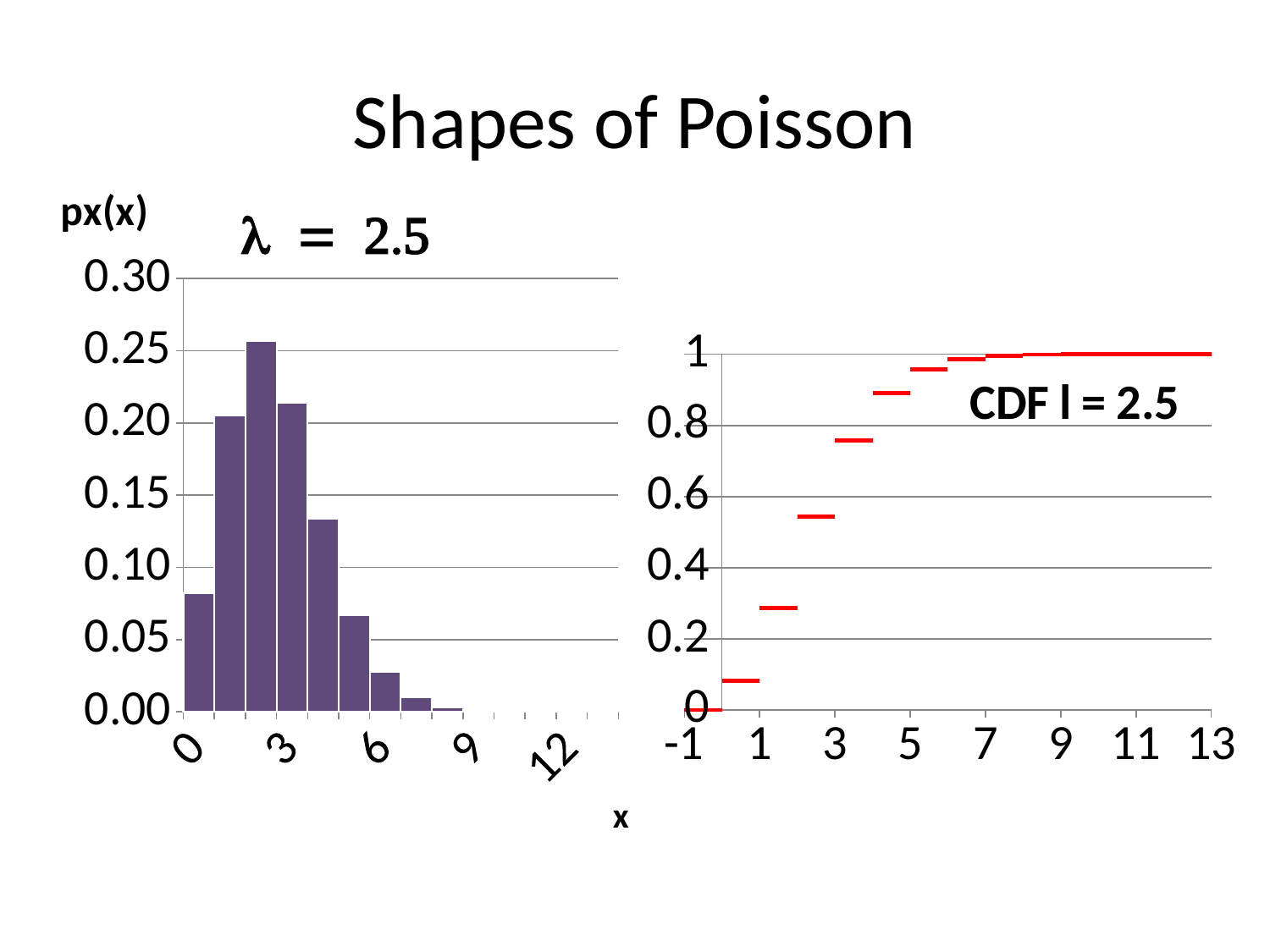
In the left chart (λ = 2.5), is the bar for x = 0 greater or less than 0.10? less In the right chart (CDF l = 2.5), is the value at x = 1 greater or less than 0.4? less In the right chart (CDF l = 2.5), is the value at x = 2 greater or less than 0.4? greater What is the y-axis label of the left chart? px(x) What is the title of the slide? Shapes of Poisson In the left chart (λ = 2.5), which value of x has the tallest bar? 2 What kind of chart is the left chart (λ = 2.5)? bar chart In the left chart (λ = 2.5), which bar is taller, x = 2 or x = 4? x = 2 In the right chart (CDF l = 2.5), do the values rise or fall as x increases? rise